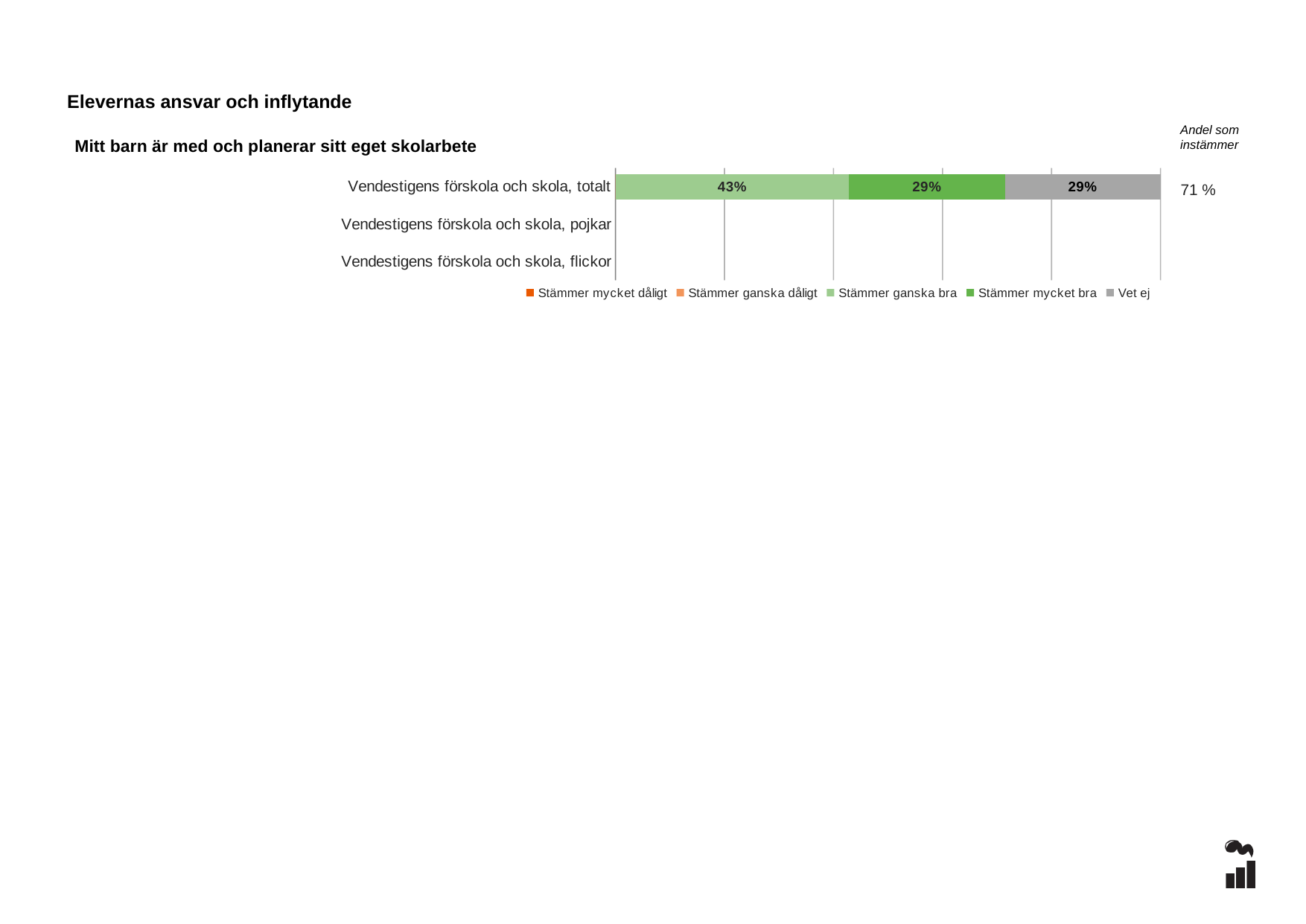
What is the value for "Stämmer ganska bra" for "Vendestigens förskola och skola, totalt"? 43% What is the difference between the "Stämmer ganska bra" and "Stämmer mycket bra" values for "Vendestigens förskola och skola, totalt"? 14% What is the value for "Stämmer mycket bra" for "Vendestigens förskola och skola, totalt"? 29% Which is larger for "Vendestigens förskola och skola, totalt": the "Stämmer ganska bra" value or the "Vet ej" value? Stämmer ganska bra What is the title of the chart? Mitt barn är med och planerar sitt eget skolarbete How many categories are listed on the vertical axis of the chart? 3 Which series has the largest value in the bar for "Vendestigens förskola och skola, totalt"? Stämmer ganska bra How many series does the legend list? 5 What is the first entry in the chart's legend? Stämmer mycket dåligt What is the "Andel som instämmer" value shown for "Vendestigens förskola och skola, totalt"? 71 % What is the value for "Vet ej" for "Vendestigens förskola och skola, totalt"? 29% What kind of chart is shown on the slide? bar chart